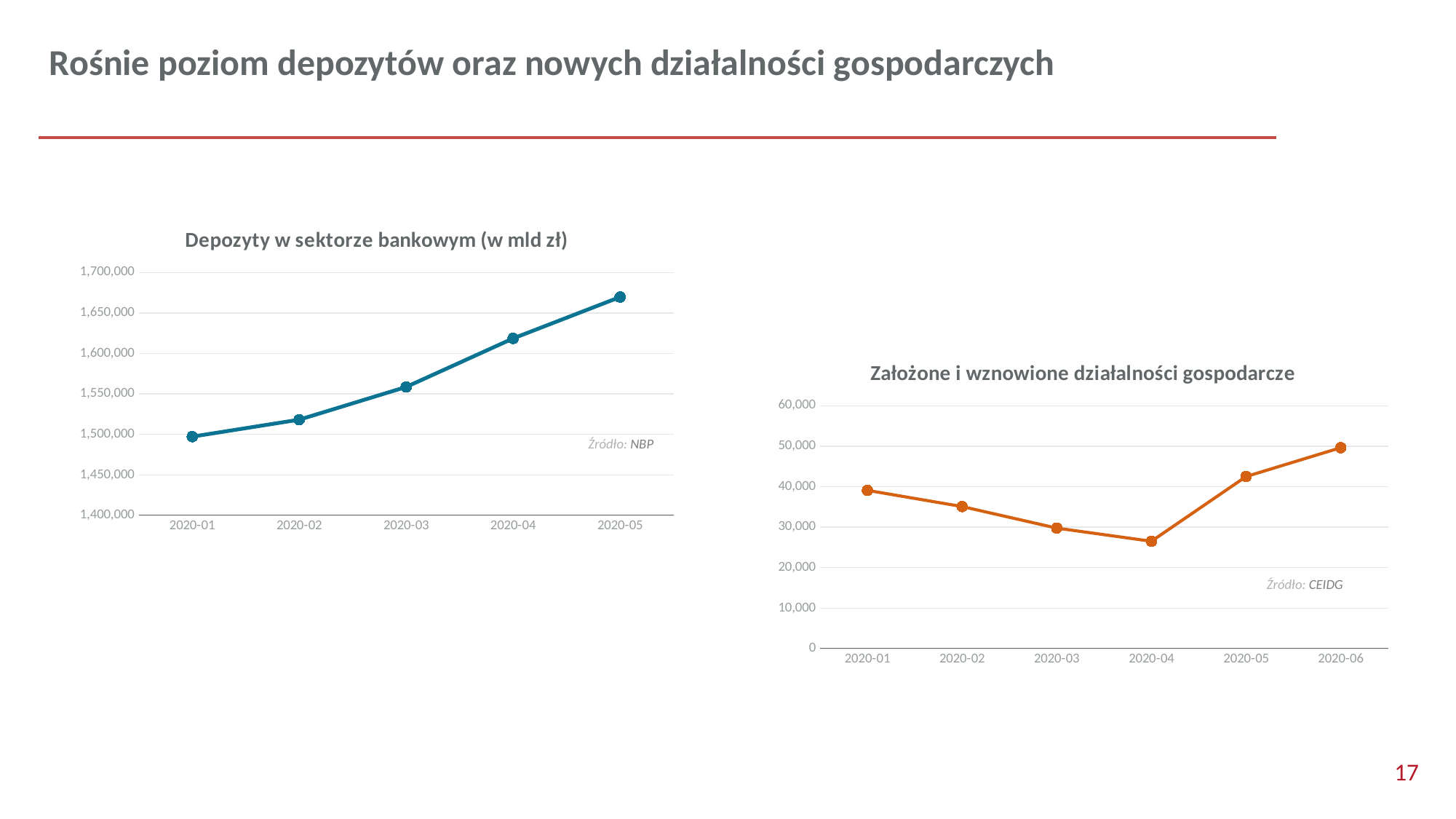
What type of chart is "Założone i wznowione działalności gospodarcze"? line chart In the "Założone i wznowione działalności gospodarcze" chart, is the value for 2020-04 greater or less than 30,000? less In the "Założone i wznowione działalności gospodarcze" chart, which month has the highest value? 2020-06 In the "Depozyty w sektorze bankowym (w mld zł)" chart, do the values rise or fall from 2020-01 to 2020-05? rise How many data points are plotted in the "Założone i wznowione działalności gospodarcze" chart? 6 In the "Depozyty w sektorze bankowym (w mld zł)" chart, which month has the highest value? 2020-05 How many data points are plotted in the "Depozyty w sektorze bankowym (w mld zł)" chart? 5 In the "Założone i wznowione działalności gospodarcze" chart, which is larger, the value for 2020-01 or the value for 2020-03? 2020-01 What type of chart is "Depozyty w sektorze bankowym (w mld zł)"? line chart In the "Depozyty w sektorze bankowym (w mld zł)" chart, is the value for 2020-05 greater or less than 1,650,000? greater In the "Założone i wznowione działalności gospodarcze" chart, which month has the lowest value? 2020-04 In the "Depozyty w sektorze bankowym (w mld zł)" chart, is the value for 2020-03 greater or less than 1,600,000? less